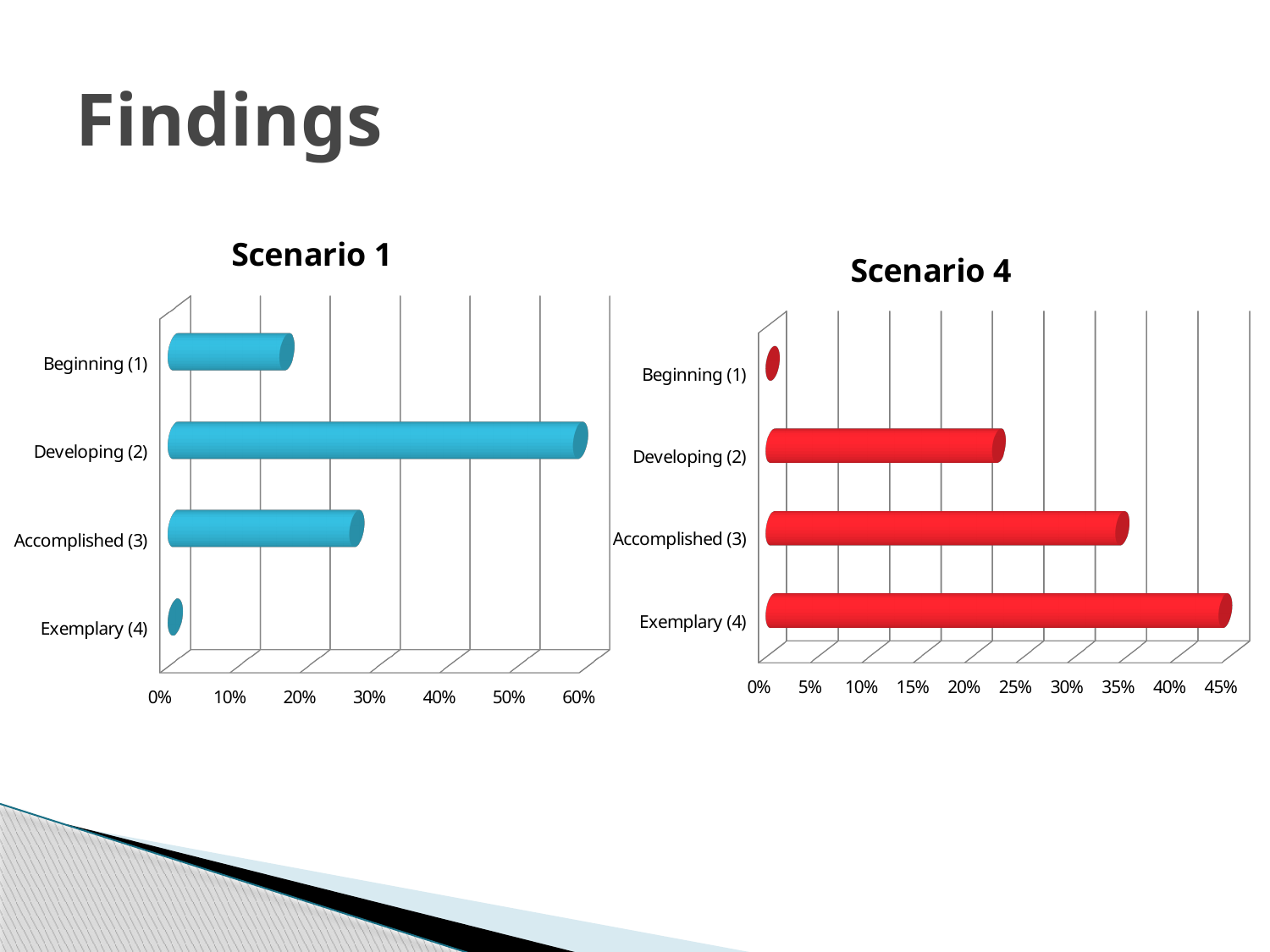
What colour are the bars in the Scenario 4 chart? red In the Scenario 4 chart, which category has the highest value? Exemplary (4) In the Scenario 4 chart, is the value for Exemplary (4) greater or less than 40%? greater What kind of chart is the Scenario 1 chart? bar chart In the Scenario 1 chart, is the value for Accomplished (3) greater or less than 20%? greater In the Scenario 4 chart, which category has the lowest value? Beginning (1) In the Scenario 1 chart, is the value for Developing (2) greater or less than 50%? greater In the Scenario 1 chart, which category has the lowest value? Exemplary (4) In the Scenario 1 chart, which category has the highest value? Developing (2) How many categories are shown in the Scenario 4 chart? 4 In the Scenario 1 chart, which is larger, the value for Beginning (1) or Accomplished (3)? Accomplished (3) In the Scenario 4 chart, which is larger, the value for Developing (2) or Accomplished (3)? Accomplished (3)